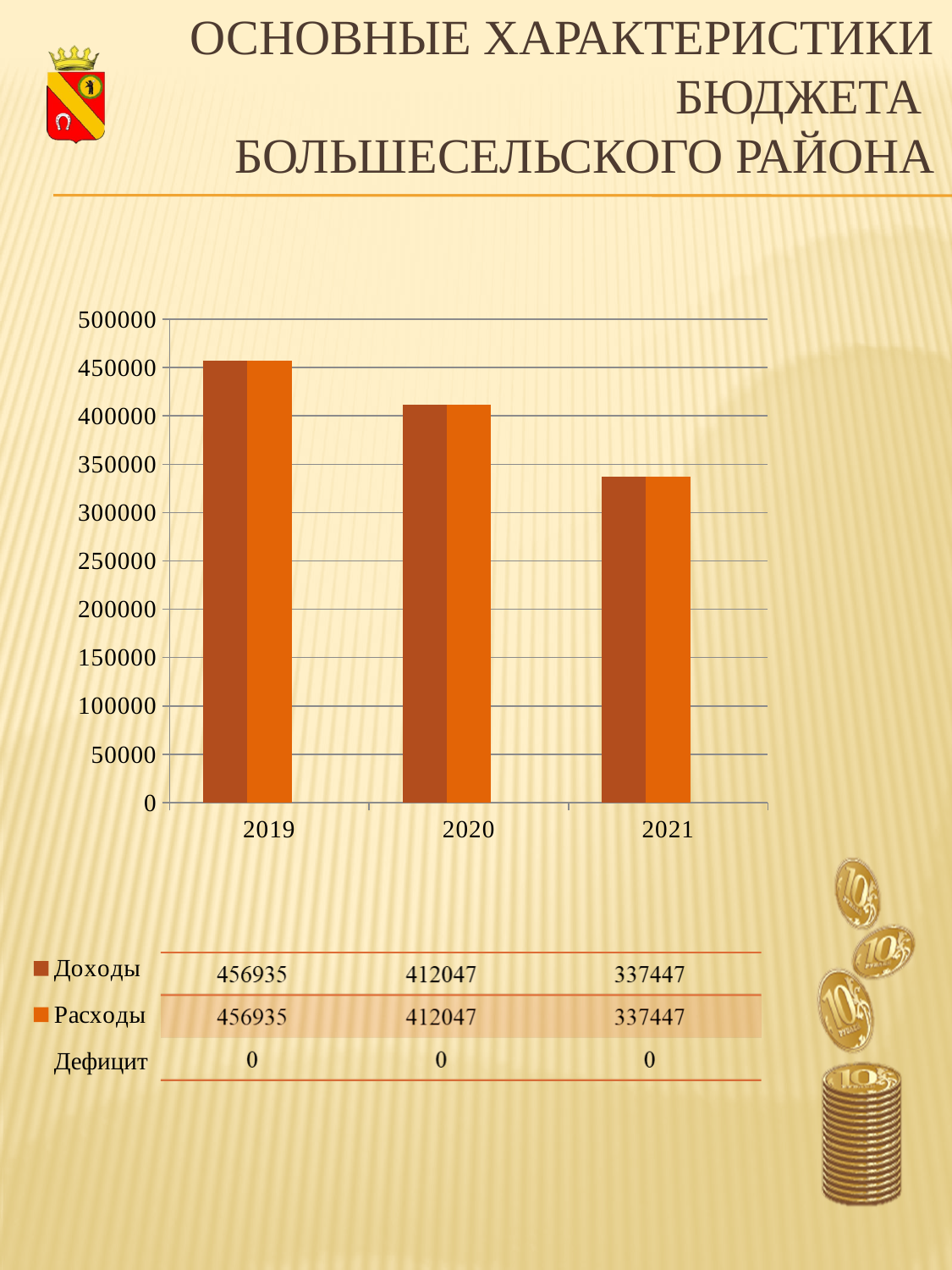
What is the value of Дефицит for 2020? 0 How many series does the legend list? 3 Do the Доходы values rise or fall from 2019 to 2021? fall What is the value of Доходы for 2019? 456935 In which year is Расходы the lowest? 2021 What is the value of Доходы for 2021? 337447 How many years are shown on the x axis? 3 What is the value of Расходы for 2020? 412047 What type of chart is shown on the slide? bar chart Which is larger: Расходы in 2020 or Расходы in 2021? Расходы in 2020 In which year is Доходы the highest? 2019 What is the difference between Доходы in 2019 and Доходы in 2021? 119488